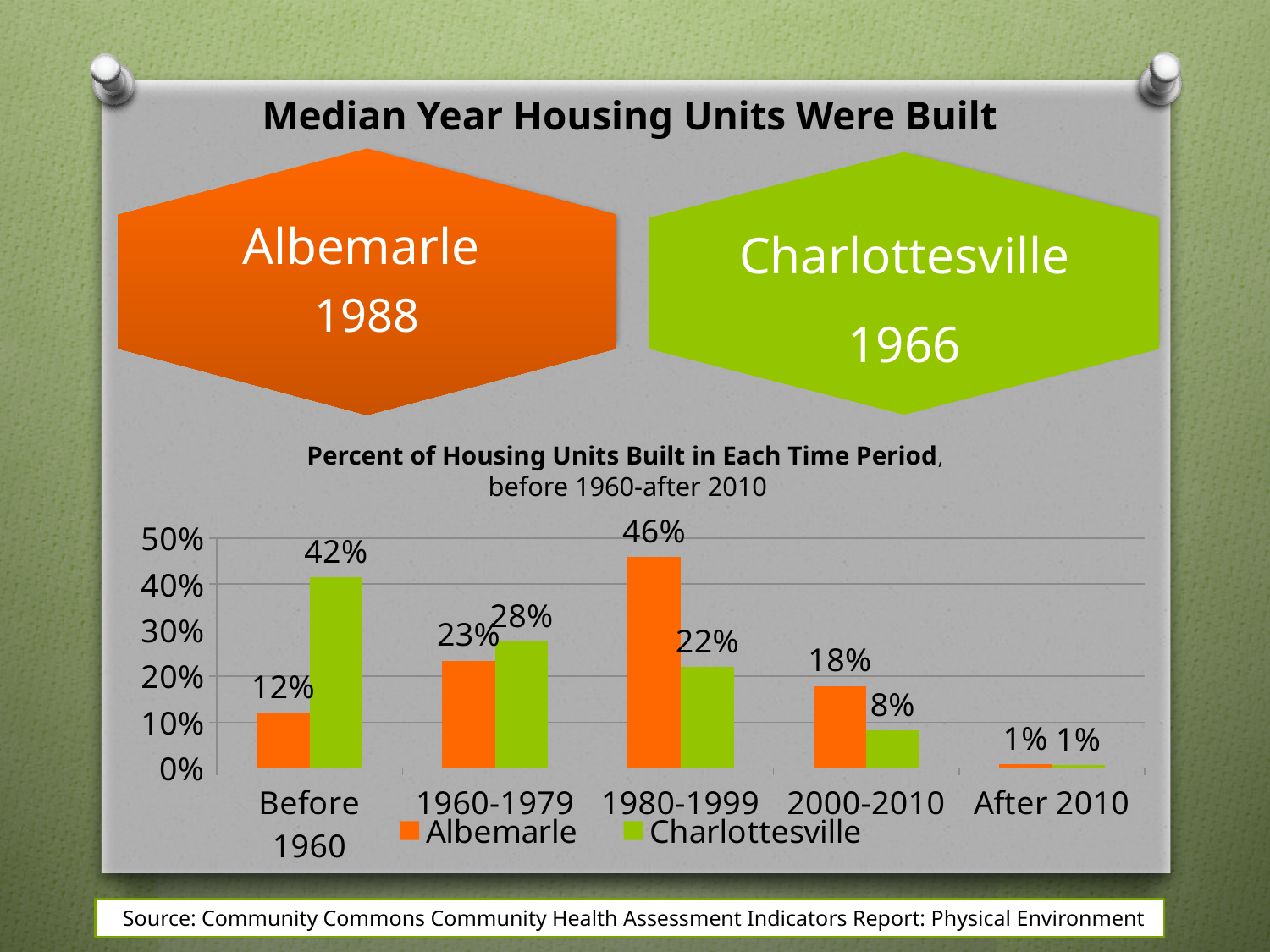
What percent of Albemarle housing units were built before 1960? 12% How many series does the chart legend list? 2 What percent of Charlottesville housing units were built in 2000-2010? 8% What is the difference between the Charlottesville and Albemarle values for Before 1960? 30% In which time period is the Albemarle value highest? 1980-1999 What percent of Charlottesville housing units were built in 1980-1999? 22% What kind of chart is shown on the slide? Bar chart In which time period is the Charlottesville value lowest? After 2010 Which is larger for 1960-1979, the Albemarle value or the Charlottesville value? Charlottesville What is the difference between the Albemarle and Charlottesville values for 1980-1999? 24% Which colour represents Charlottesville in the chart? Green How many time periods are shown on the x axis of the chart? 5